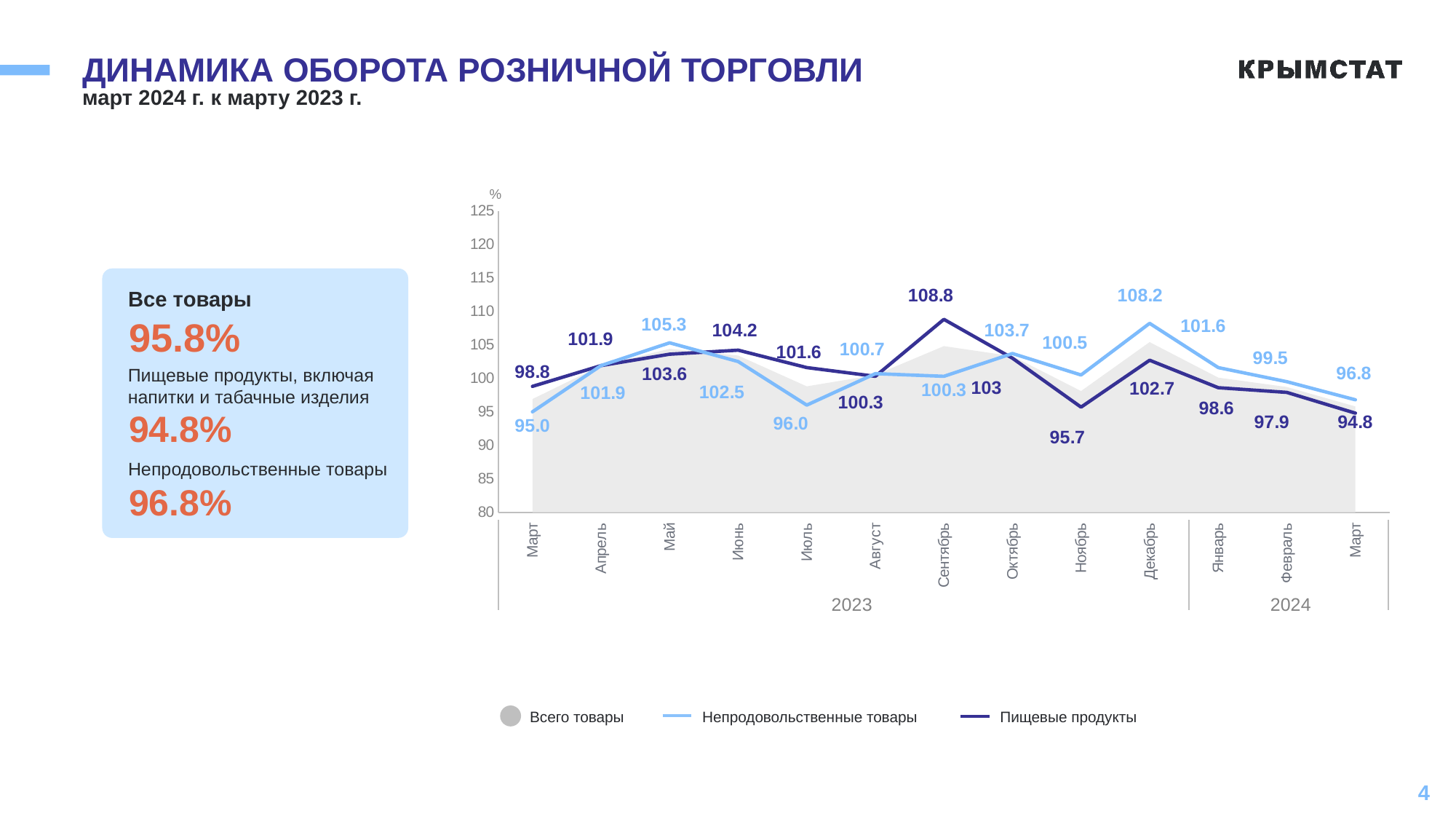
Is the value for Всего товары in Сентябрь 2023 greater or less than 100? greater From Декабрь 2023 to Март 2024, does the Непродовольственные товары line rise or fall? fall What is the difference between Пищевые продукты and Непродовольственные товары in Сентябрь 2023? 8.5 In which month does Пищевые продукты have its lowest value? Март 2024 What is the value for Пищевые продукты in Сентябрь 2023? 108.8 What is the value for Непродовольственные товары in Май 2023? 105.3 In which month does Непродовольственные товары reach its highest value? Декабрь What kind of chart is shown on the slide? combination area and line chart How many series does the legend list? 3 How many months are plotted on the x axis? 13 In Ноябрь 2023, which series is higher: Непродовольственные товары or Пищевые продукты? Непродовольственные товары What is the value for Пищевые продукты in Март 2024? 94.8